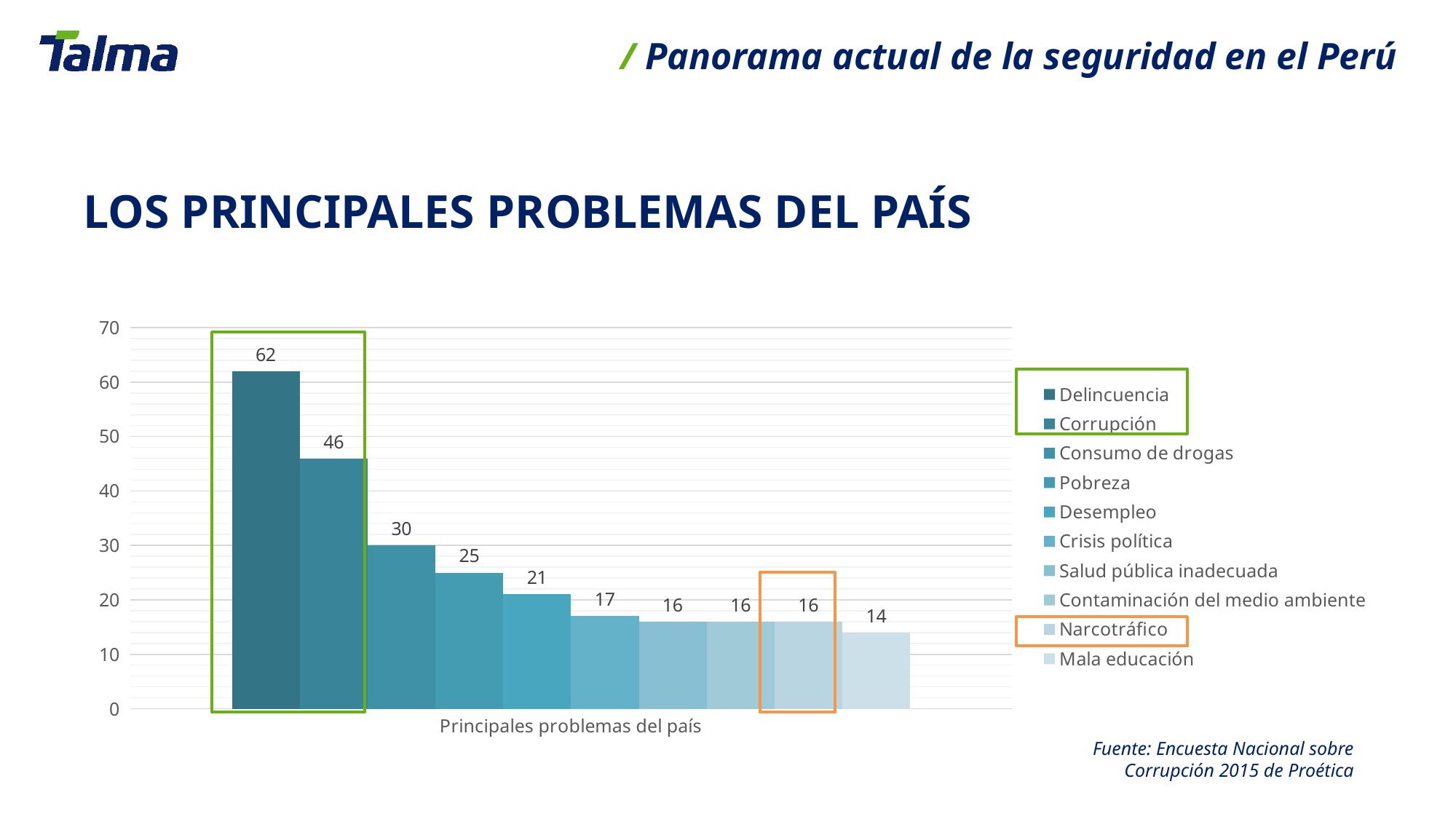
What value is shown for Delincuencia? 62 How many series does the legend list? 10 Which legend entry is highlighted with an orange box? Narcotráfico Which series has the lowest value? Mala educación Which series has the highest value? Delincuencia What value is shown for Corrupción? 46 What value is shown for Mala educación? 14 What value is shown for Consumo de drogas? 30 What kind of chart is shown on the slide? Bar chart What is the difference between the values for Delincuencia and Corrupción? 16 Which is larger, the value for Pobreza or the value for Desempleo? Pobreza What is the x-axis category label of the chart? Principales problemas del país